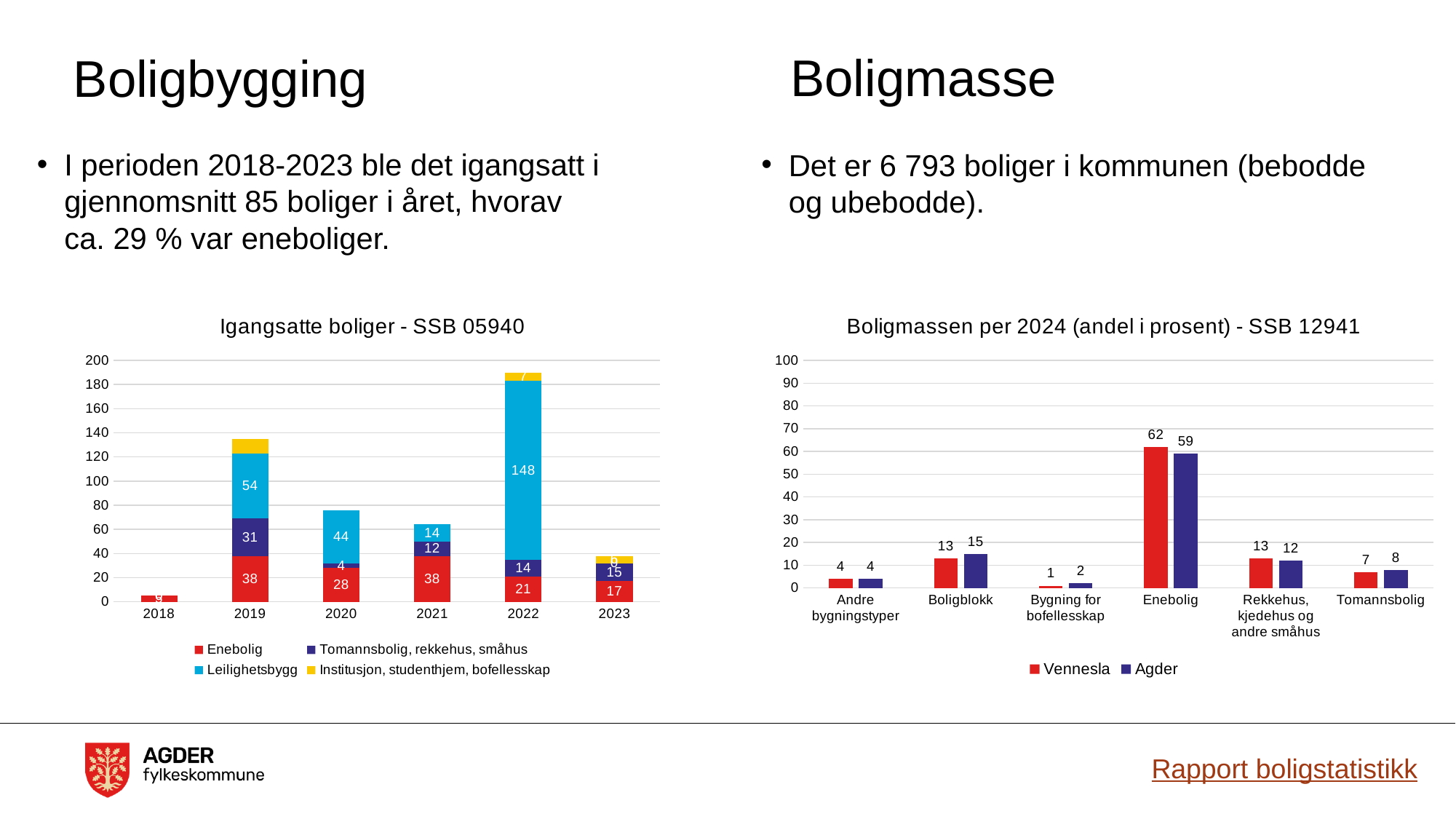
In the chart 'Igangsatte boliger - SSB 05940', what is the value for Leilighetsbygg in 2022? 148 In the chart 'Igangsatte boliger - SSB 05940', what is the value for Tomannsbolig, rekkehus, småhus in 2020? 4 In the chart 'Boligmassen per 2024 (andel i prosent) - SSB 12941', which category has the lowest value for Vennesla? Bygning for bofellesskap In the chart 'Boligmassen per 2024 (andel i prosent) - SSB 12941', how many categories are shown on the x axis? 6 In the chart 'Igangsatte boliger - SSB 05940', how many series does the legend list? 4 In the chart 'Igangsatte boliger - SSB 05940', what is the total of the stacked bar for 2022? 190 In the chart 'Igangsatte boliger - SSB 05940', which year has the highest total of started dwellings? 2022 In the chart 'Igangsatte boliger - SSB 05940', what is the difference between the Enebolig values for 2021 and 2023? 21 In the chart 'Boligmassen per 2024 (andel i prosent) - SSB 12941', what is the value for Agder for Boligblokk? 15 In the chart 'Boligmassen per 2024 (andel i prosent) - SSB 12941', what is the value for Vennesla for Enebolig? 62 What kind of chart is 'Boligmassen per 2024 (andel i prosent) - SSB 12941'? Bar chart In the chart 'Igangsatte boliger - SSB 05940', what is the value for Enebolig in 2019? 38